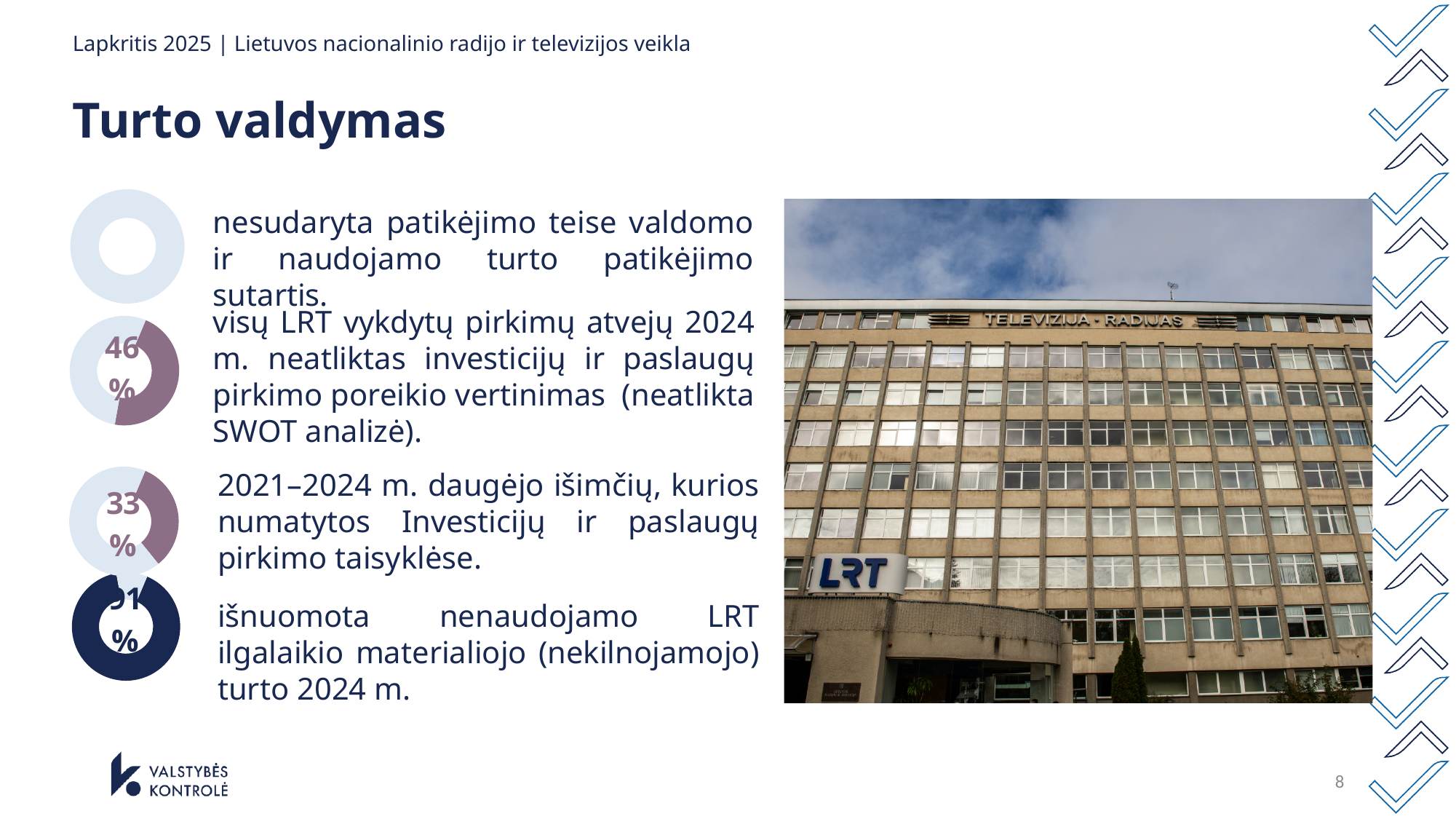
What colour is the filled portion of the donut chart showing 46%? purple What kind of charts are shown on the left side of the slide? donut charts What percentage is shown in the donut chart next to the text about exceptions in the Investment and service purchase rules increasing in 2021–2024? 33% Which is larger: the value in the donut chart about the 2024 purchase needs assessment or the value in the donut chart about exceptions in 2021–2024? 46% Is the value in the donut chart about the 2024 purchase needs assessment greater or less than 50%? less What percentage is shown in the donut chart next to the text about LRT purchases in 2024 lacking an investment and service purchase needs assessment (SWOT analysis)? 46% How many donut charts are shown on the slide? 4 What is the difference between the 46% donut chart and the 33% donut chart? 13%